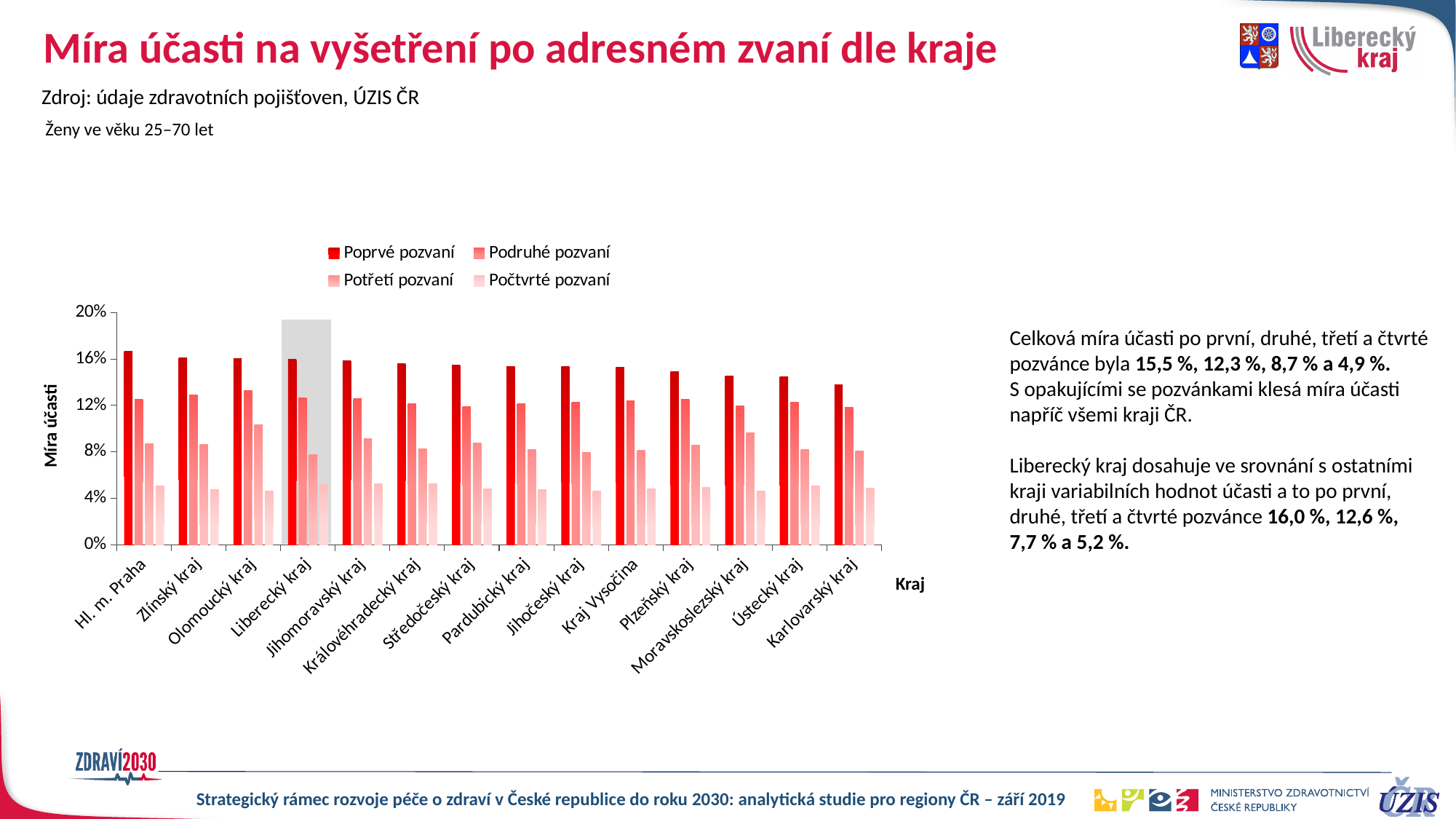
What is the label of the vertical axis? Míra účasti How many regions (kraje) are shown on the x axis? 14 According to the slide, what is the participation rate for Liberecký kraj after the first invitation (Poprvé pozvaní)? 16,0 % According to the slide, what is the participation rate for Liberecký kraj after the fourth invitation (Počtvrté pozvaní)? 5,2 % Is the value for Poprvé pozvaní in Karlovarský kraj greater or less than 16%? less Is the value for Poprvé pozvaní in Hl. m. Praha greater or less than 16%? greater Which region has the lowest value for Poprvé pozvaní? Karlovarský kraj Which is larger for Liberecký kraj: Poprvé pozvaní or Podruhé pozvaní? Poprvé pozvaní What kind of chart is shown on the slide? bar chart How many series does the legend list? 4 Which region has the highest value for Poprvé pozvaní? Hl. m. Praha Is the value for Potřetí pozvaní in Olomoucký kraj greater or less than 8%? greater